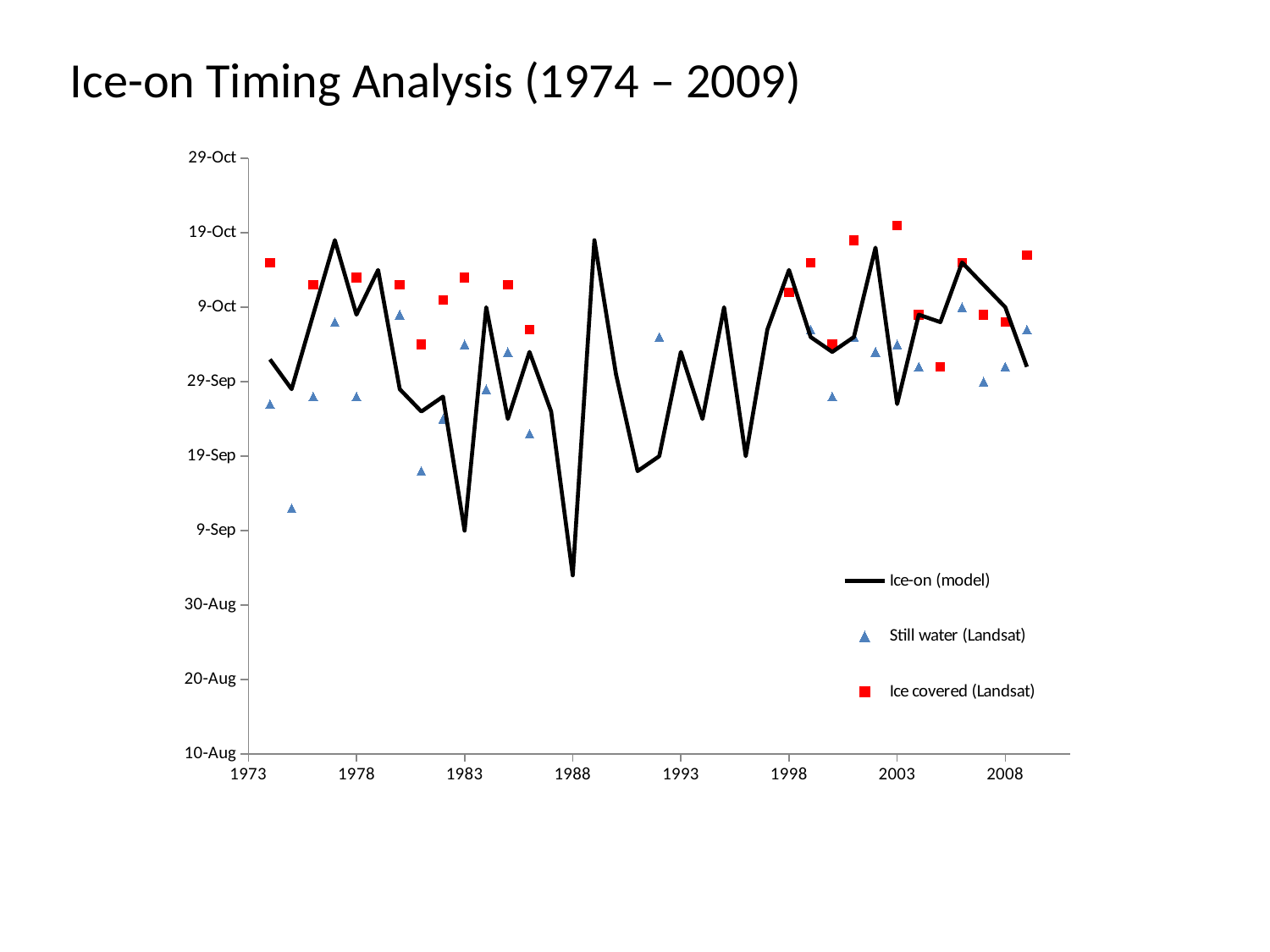
What kind of chart is shown on the slide? line and scatter chart Is the Still water (Landsat) value for 1975 greater or less than 19-Sep? less Is the Ice-on (model) value for 1989 greater or less than 9-Oct? greater Is the Ice covered (Landsat) value for 1974 greater or less than 9-Oct? greater What is the title of the chart? Ice-on Timing Analysis (1974 – 2009) For 1974, which is later, the Ice covered (Landsat) point or the Still water (Landsat) point? Ice covered (Landsat) In which year does the Ice-on (model) line reach its lowest point? 1988 Which series is drawn as a black line? Ice-on (model) Does the Ice-on (model) line rise or fall between 1988 and 1989? rise Which is later on the Ice-on (model) line, the value for 1988 or the value for 1989? 1989 How many series does the legend list? 3